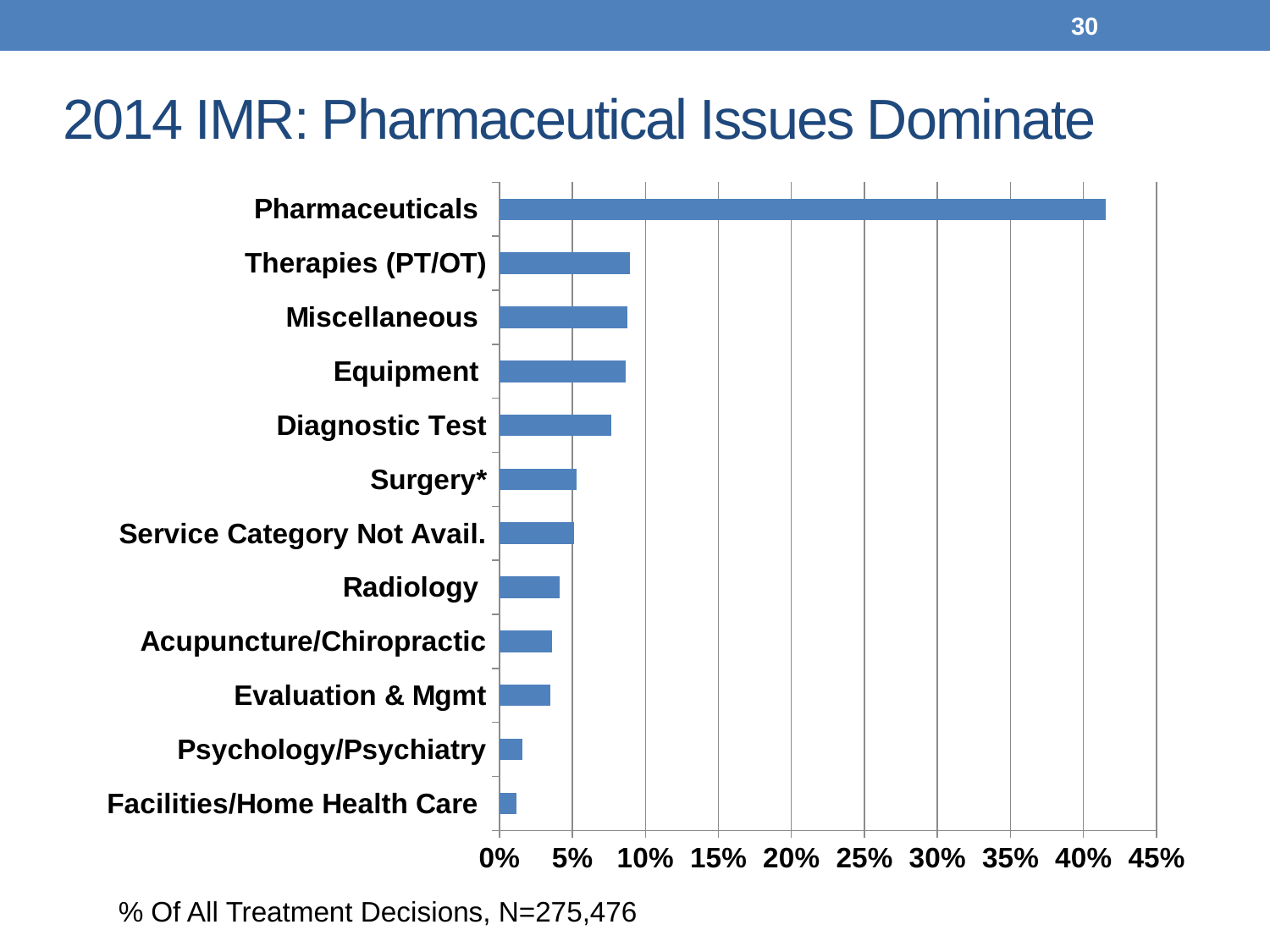
Which category has the lowest value in the chart? Facilities/Home Health Care Is the value for Therapies (PT/OT) greater or less than 10%? less Which category has the highest value in the chart? Pharmaceuticals What kind of chart is shown on the slide? Bar chart Is the value for Pharmaceuticals greater or less than 40%? greater Is the value for Radiology greater or less than 5%? less What is the title of the chart on the slide? 2014 IMR: Pharmaceutical Issues Dominate Which is larger, the value for Surgery* or the value for Psychology/Psychiatry? Surgery* Which is larger, the value for Diagnostic Test or the value for Radiology? Diagnostic Test How many categories are plotted in the chart? 12